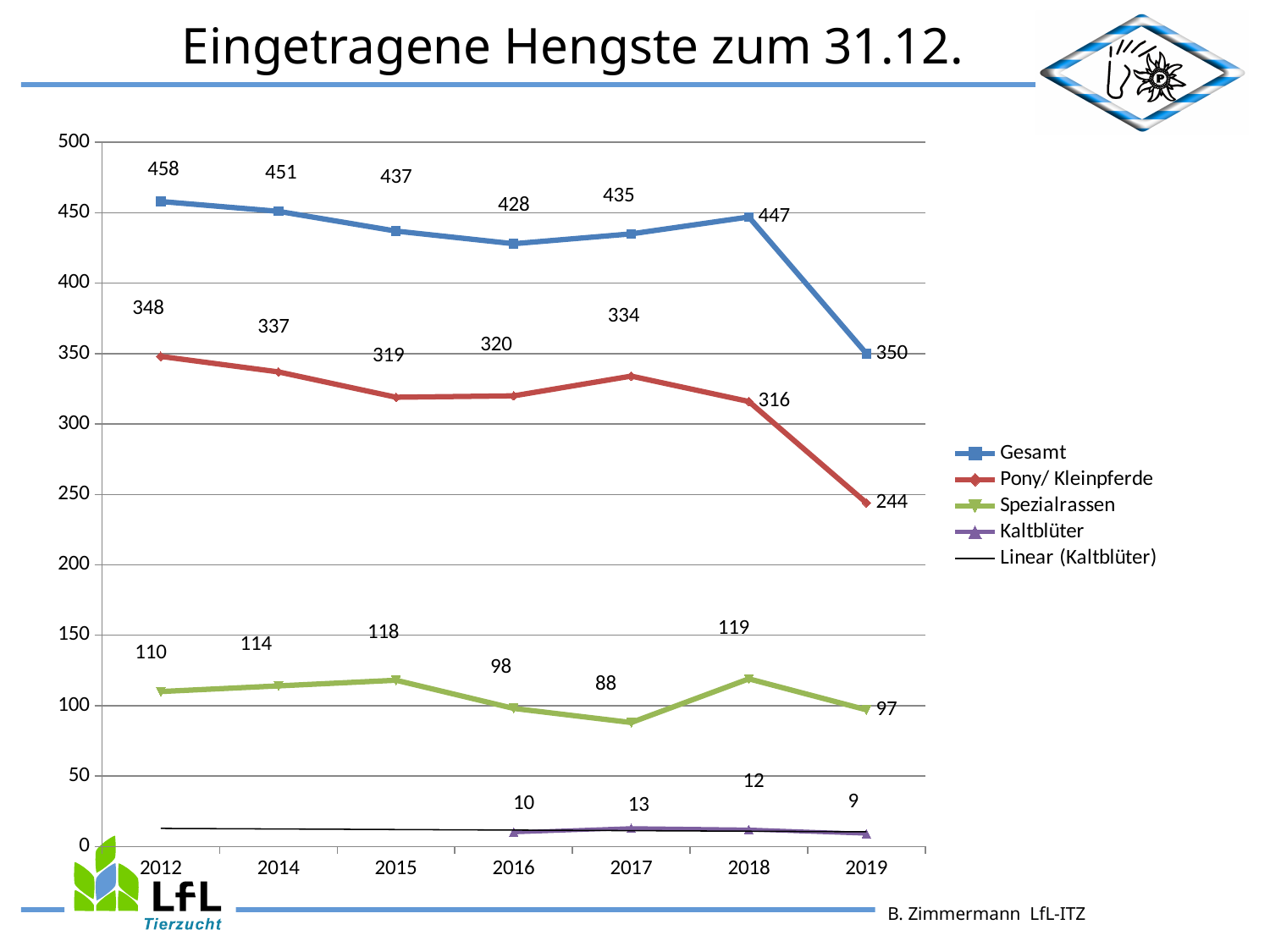
What is the value for Pony/ Kleinpferde in 2019? 244 In which year is the Spezialrassen value highest? 2018 What is the value for Kaltblüter in 2018? 12 In which year is the Gesamt value lowest? 2019 What is the difference between the Gesamt values for 2018 and 2019? 97 Which is larger, the Pony/ Kleinpferde value in 2012 or in 2017? 2012 What type of chart is shown on the slide? line chart What is the value for Spezialrassen in 2017? 88 What is the value for Gesamt in 2012? 458 How many years are shown on the x axis? 7 What is the title of the chart? Eingetragene Hengste zum 31.12. How many series does the legend list? 5